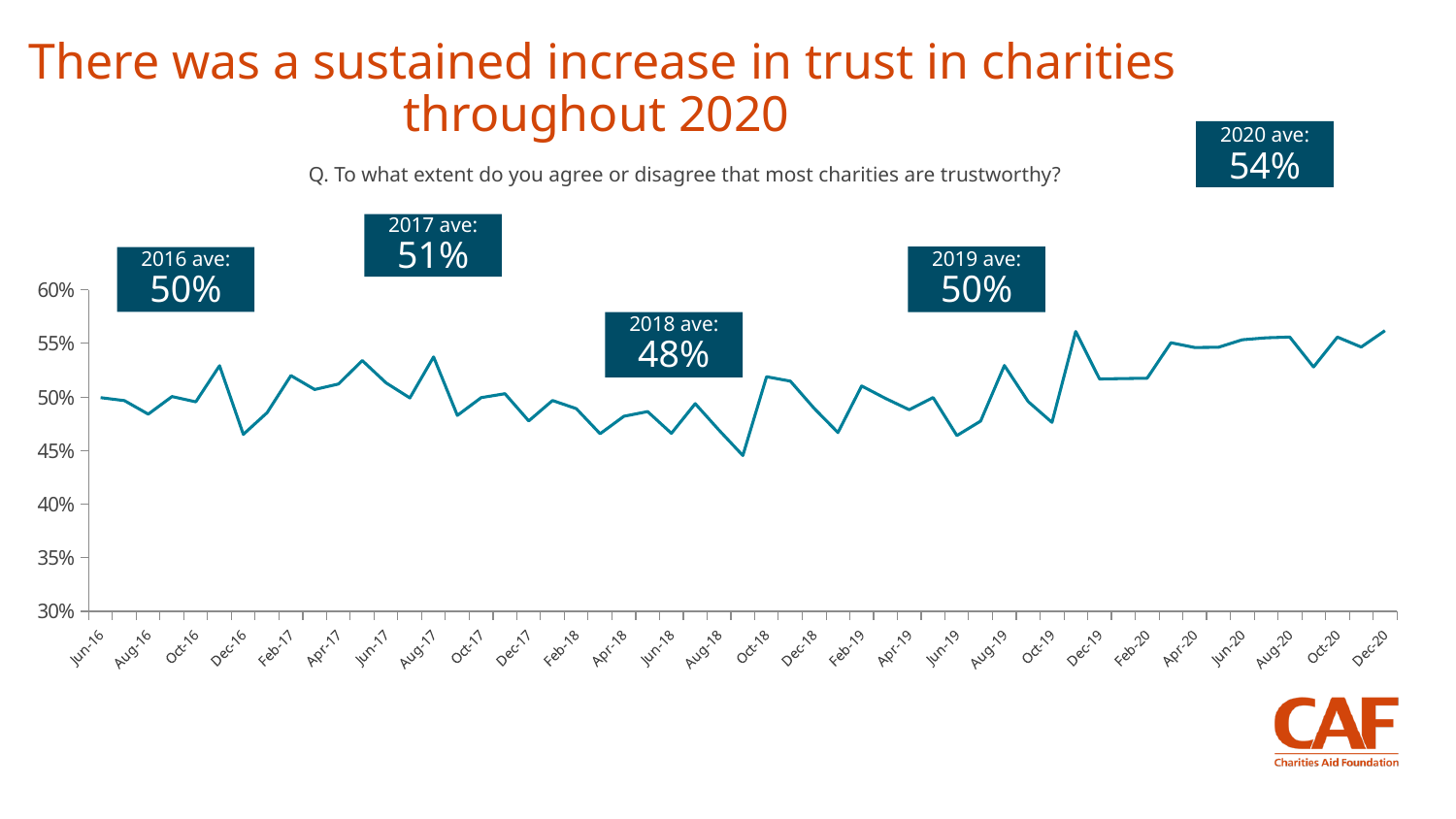
What is the 2020 average shown on the slide? 54% What kind of chart is shown on the slide? line chart Overall, do the values rise or fall from Jun-16 to Dec-20? rise Which is larger, the 2017 average or the 2019 average? 2017 average What is the 2016 average shown on the slide? 50% Is the value for Dec-16 greater or less than 50%? less What is the 2017 average shown on the slide? 51% Which year has the highest annual average shown on the slide? 2020 Is the value for Dec-20 greater or less than 55%? greater What is the difference between the 2020 average and the 2018 average? 6 percentage points What is the 2018 average shown on the slide? 48% Which year has the lowest annual average shown on the slide? 2018